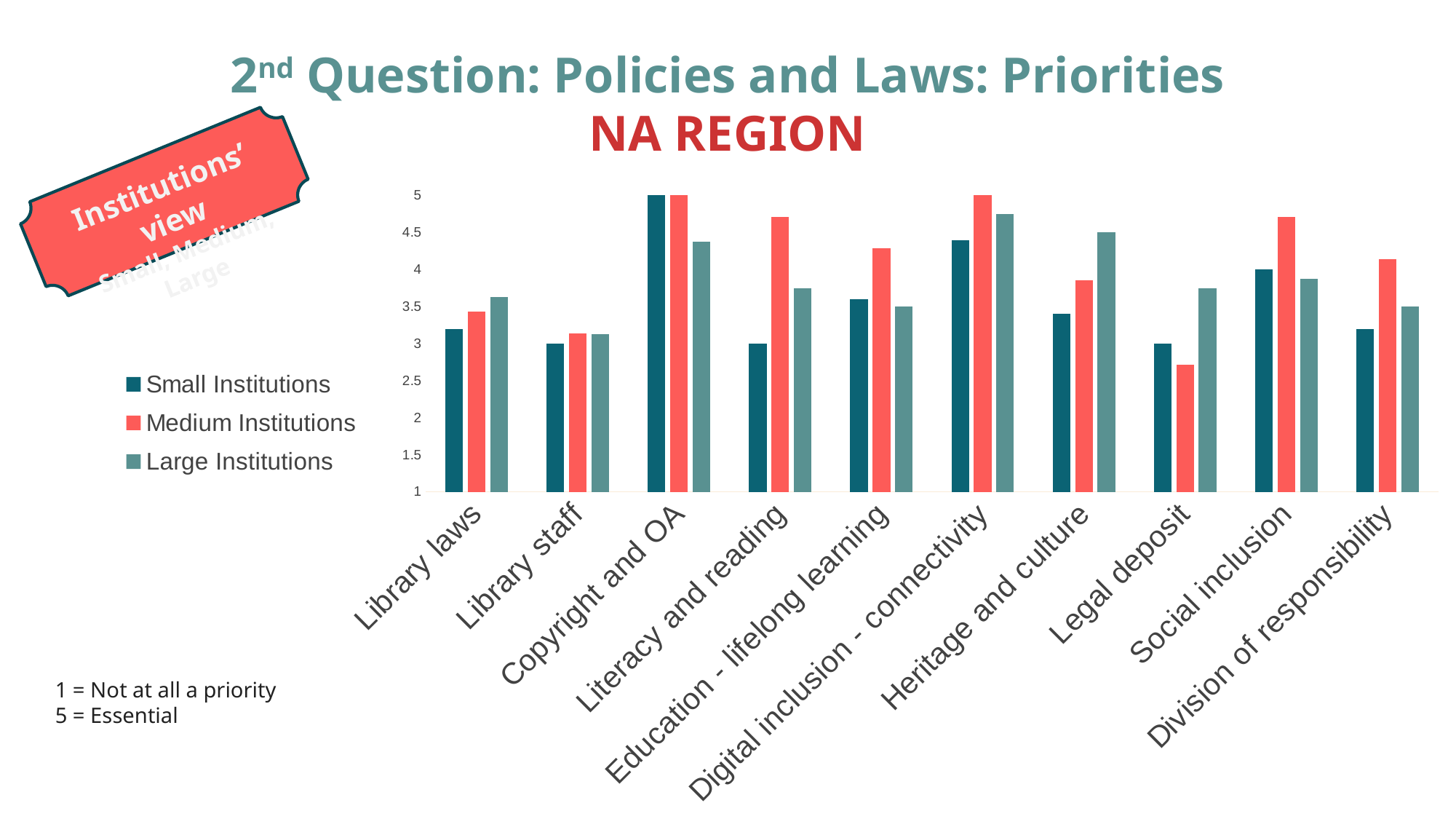
How many categories are shown along the x axis? 10 Is the value for Large Institutions in Heritage and culture greater or less than 4? greater In Education - lifelong learning, which is larger: Medium Institutions or Large Institutions? Medium Institutions How many series does the legend list? 3 In Heritage and culture, which is larger: Small Institutions or Large Institutions? Large Institutions What kind of chart is shown on the slide? bar chart Is the value for Medium Institutions in Literacy and reading greater or less than 4.5? greater Which region is named in the chart title? NA REGION Is the value for Medium Institutions in Legal deposit greater or less than 3? less What is the value for Small Institutions in Copyright and OA? 5 Which category has the lowest value for Medium Institutions? Legal deposit Which category has the highest value for Small Institutions? Copyright and OA